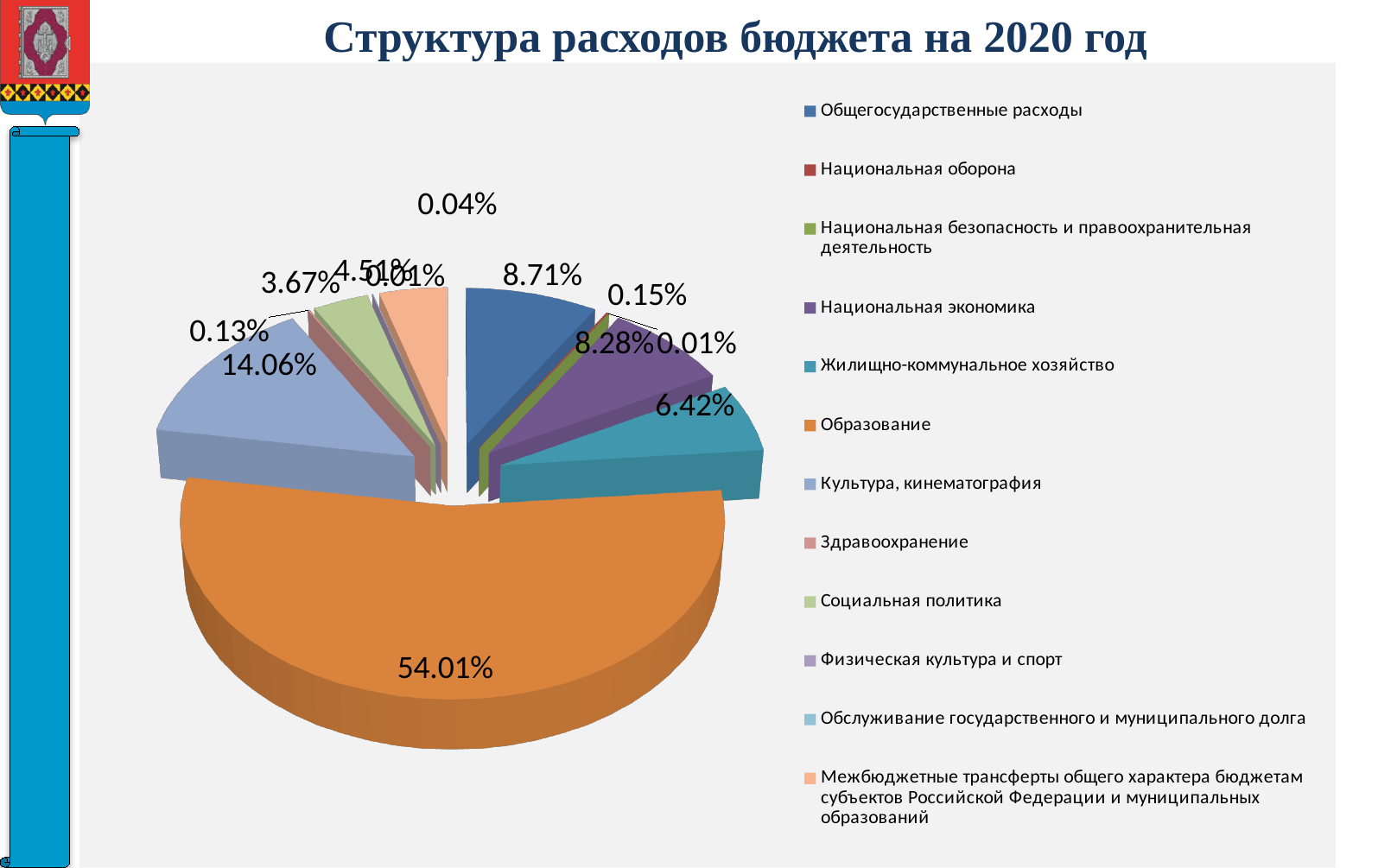
What share is shown for Общегосударственные расходы? 8.71% What colour is the slice for Образование? orange Which category has the largest share of the budget expenditure? Образование What kind of chart is shown on the slide? pie chart What is the difference between the share for Образование and the share for Культура, кинематография? 39.95% What share of the budget expenditure goes to Образование? 54.01% What share is shown for Жилищно-коммунальное хозяйство? 6.42% Which is larger: the share for Культура, кинематография or the share for Общегосударственные расходы? Культура, кинематография What share is shown for Национальная экономика? 8.28% How many categories does the legend list? 12 What is the title of the chart? Структура расходов бюджета на 2020 год What share is shown for Культура, кинематография? 14.06%